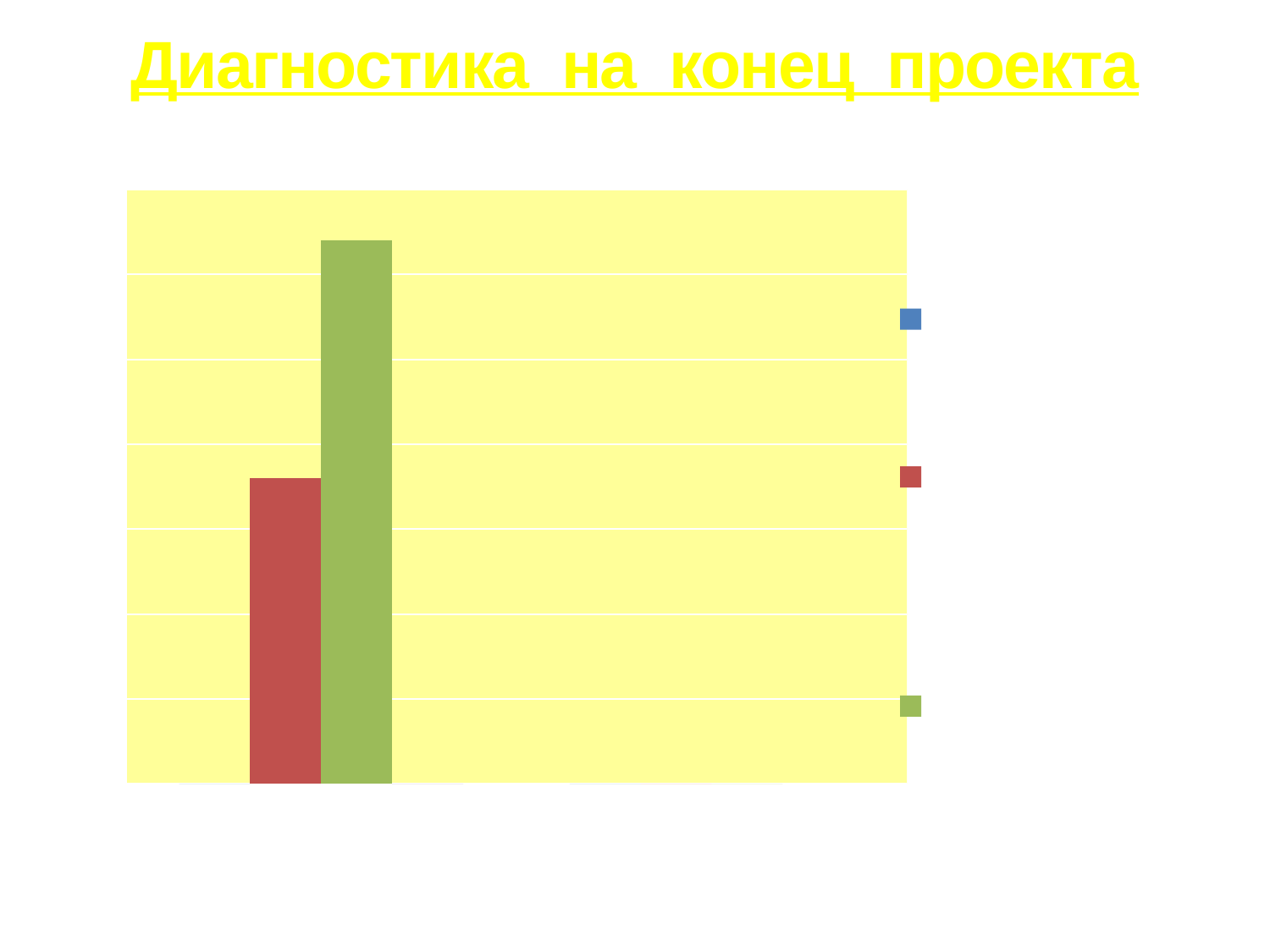
How many bars are visibly plotted in the chart? 2 What is the title of the slide with the chart? Диагностика на конец проекта What kind of chart is shown on the slide? bar chart What colours are the three legend swatches, from top to bottom? blue, red, green How many entries (colour swatches) does the chart's legend show? 3 Which coloured bar is the lowest of the visible bars in the chart? the red bar Which bar is taller, the red bar or the green bar? the green bar Which coloured bar is the highest in the chart? the green bar